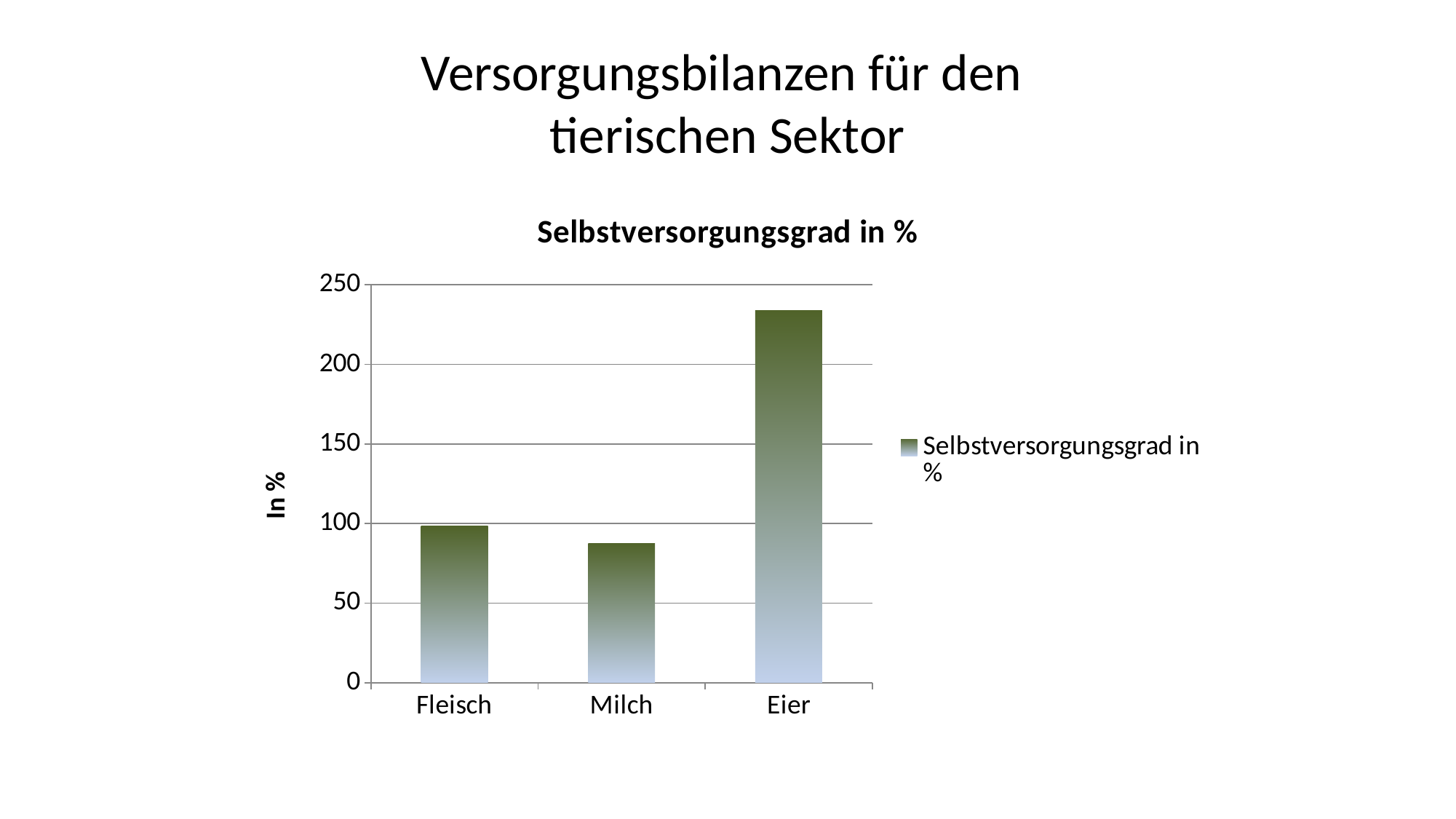
Is the value for Eier greater or less than 200? greater How many series does the legend list? 1 Is the value for Fleisch greater or less than 50? greater Which is larger, the value for Eier or the value for Fleisch? Eier How many categories are shown on the x axis of the chart? 3 Which category has the highest Selbstversorgungsgrad? Eier Which is larger, the value for Fleisch or the value for Milch? Fleisch Is the value for Milch greater or less than 100? less What is the title of the chart? Selbstversorgungsgrad in % Which category has the lowest Selbstversorgungsgrad? Milch What is the label on the vertical axis of the chart? In % What kind of chart is shown on the slide? bar chart